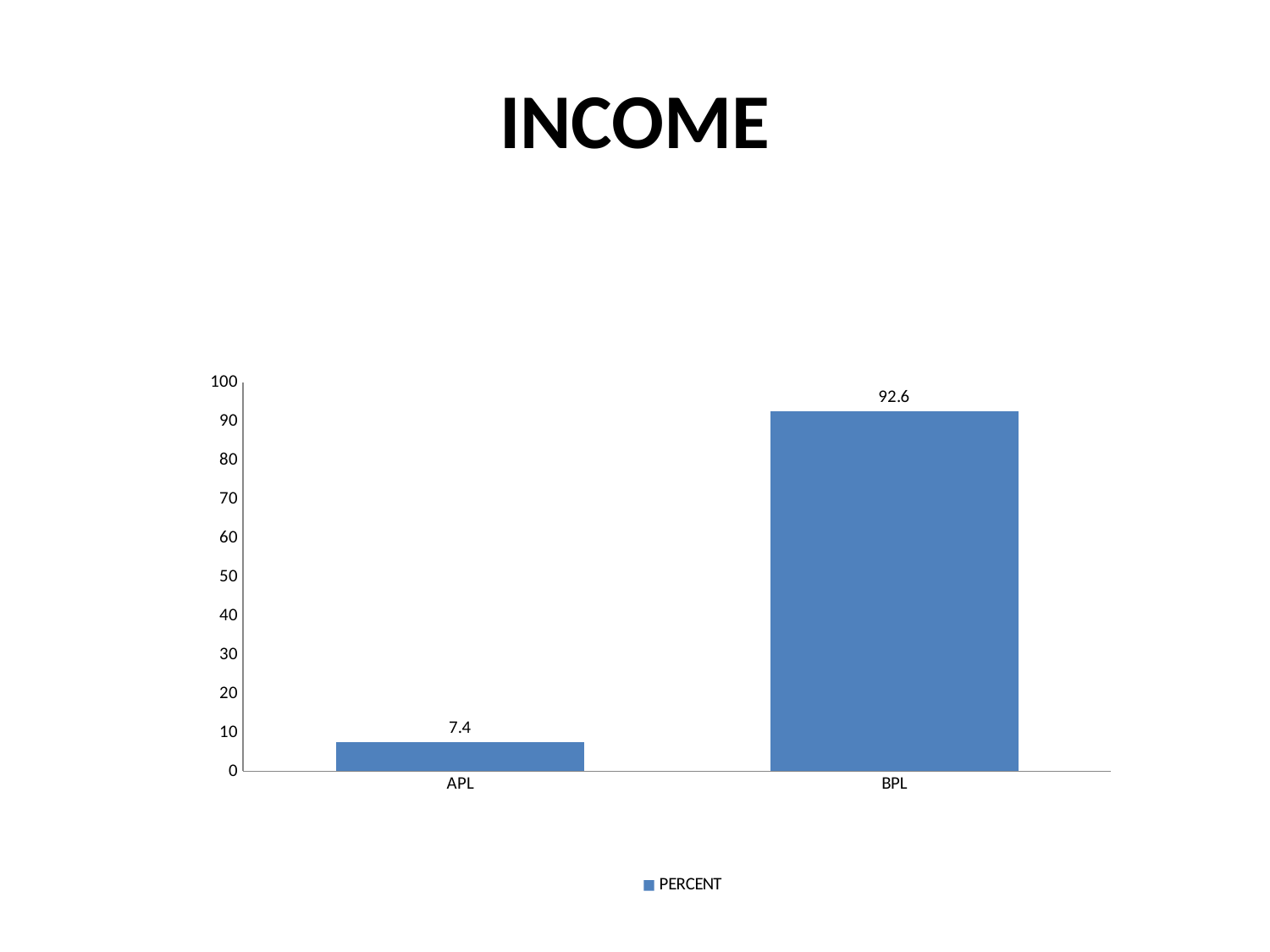
What is the value for BPL? 92.6 What is the value for APL? 7.4 How many series does the legend list? 1 What is the title of the slide? INCOME Is the value for BPL greater or less than 90? greater Is the value for APL greater or less than 10? less What is the difference between the values for BPL and APL? 85.2 How many categories are shown on the x axis? 2 Which is larger, the value for APL or the value for BPL? BPL Which category has the lowest value? APL What kind of chart is shown on the slide? bar chart Which category has the highest value? BPL